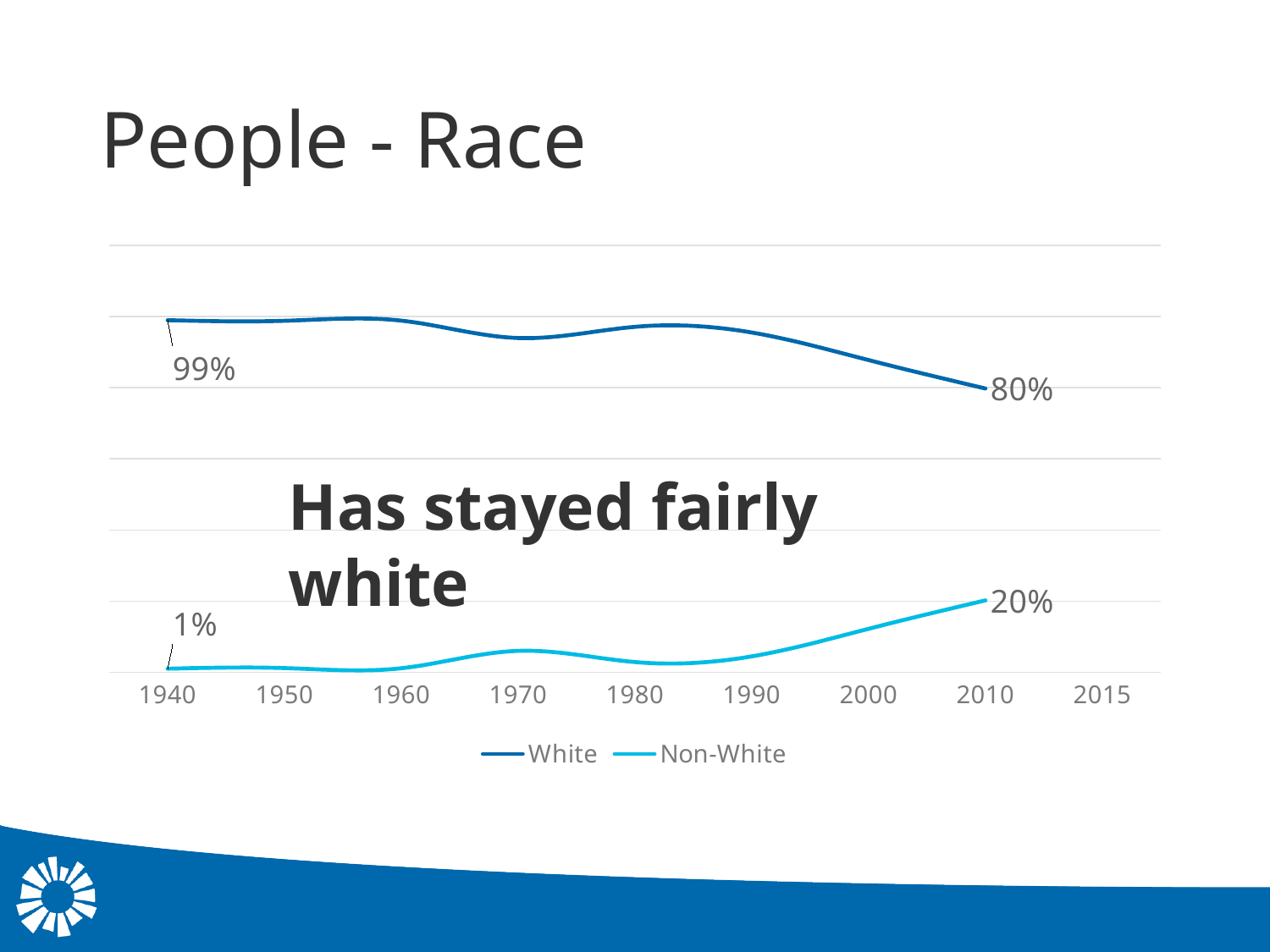
How many series does the legend list? 2 What is the value for White in 1940? 99% What is the value for Non-White in 2010? 20% What are the two series named in the legend? White and Non-White By how many percentage points did the Non-White share rise between 1940 and 2010? 19 percentage points What is the value for White in 2010? 80% In 2010, which series has the larger value, White or Non-White? White Does the White line rise or fall from 1940 to 2010? Fall What is the value for Non-White in 1940? 1% What kind of chart is shown on the slide? Line chart Does the Non-White line rise or fall from 1940 to 2010? Rise By how many percentage points did the White share fall between 1940 and 2010? 19 percentage points